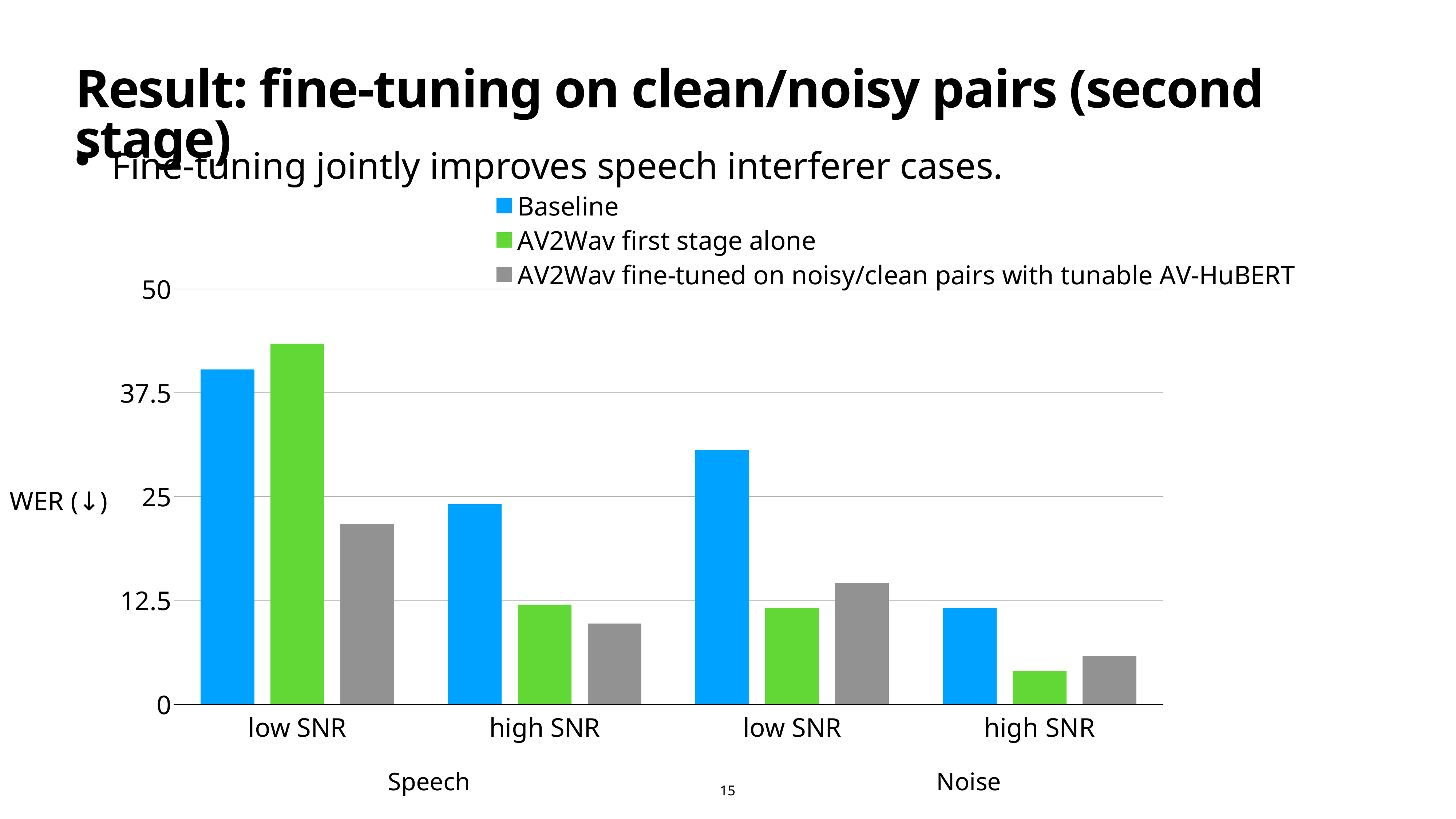
What is the label on the y axis? WER (↓) At low SNR (Noise), which is larger: AV2Wav first stage alone or AV2Wav fine-tuned on noisy/clean pairs with tunable AV-HuBERT? AV2Wav fine-tuned on noisy/clean pairs with tunable AV-HuBERT At high SNR (Speech), which is larger: Baseline or AV2Wav first stage alone? Baseline Is the Baseline value for low SNR (Speech) greater or less than 37.5? greater How many series does the legend list? 3 What kind of chart is shown on the slide? bar chart Which bar is the lowest in the chart? AV2Wav first stage alone at high SNR (Noise) Which bar is the highest in the chart? AV2Wav first stage alone at low SNR (Speech) What colour represents the Baseline series? blue How many categories are shown along the x axis? 4 Is the value for AV2Wav fine-tuned on noisy/clean pairs with tunable AV-HuBERT at low SNR (Speech) greater or less than 25? less Is the Baseline value for low SNR (Noise) greater or less than 25? greater